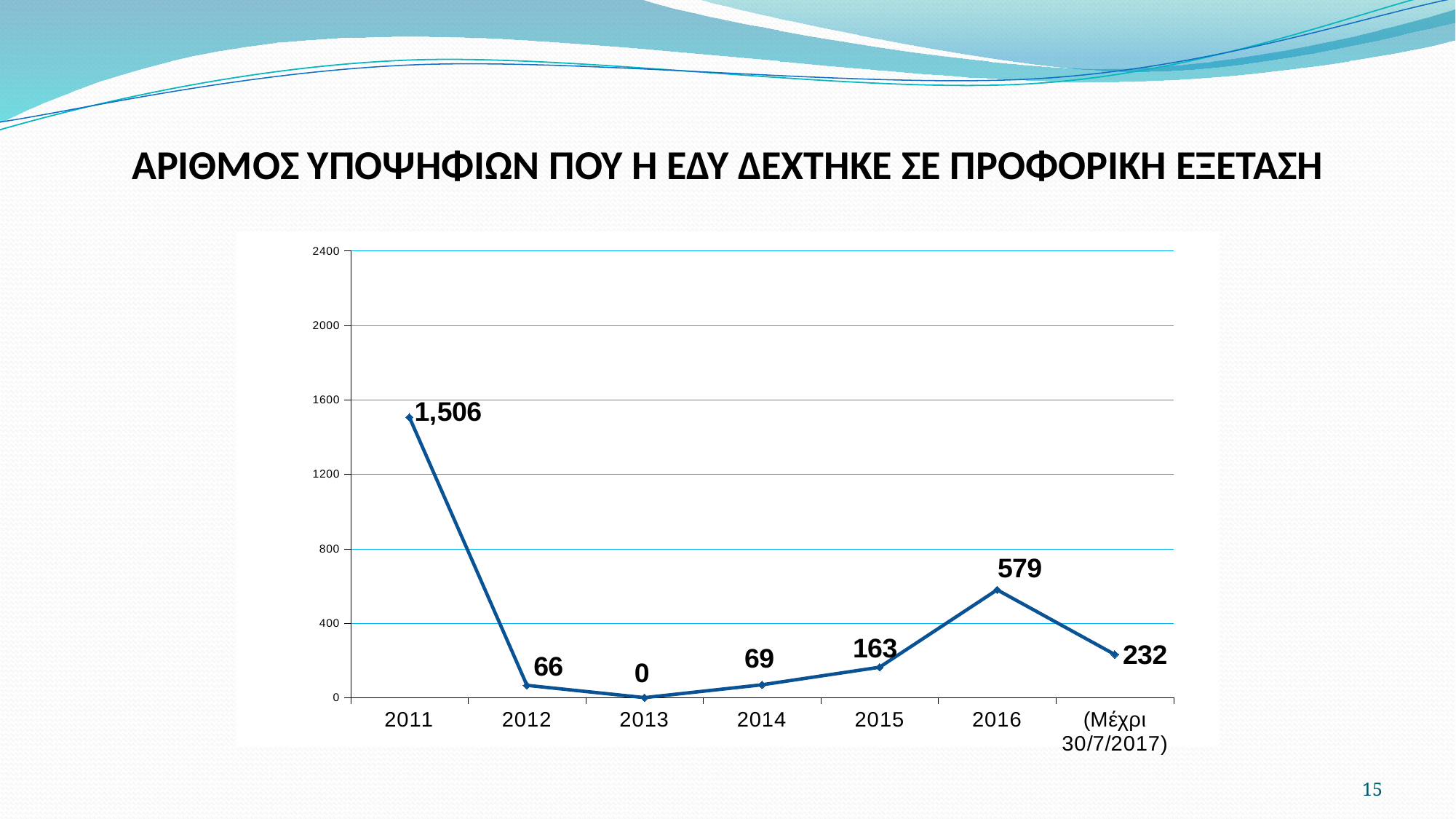
How many data points are plotted on the chart? 7 What is the difference between the values for 2014 and 2012? 3 Which year has the highest value? 2011 What kind of chart is shown on the slide? line chart What is the difference between the values for 2016 and 2015? 416 Which is larger, the value for 2015 or the value for 2014? 2015 What is the value for 2016? 579 Which year has the lowest value? 2013 What is the value for 2013? 0 What is the value for the last point, labelled (Μέχρι 30/7/2017)? 232 Do the values rise or fall from 2013 to 2016? rise What is the value for 2011? 1,506